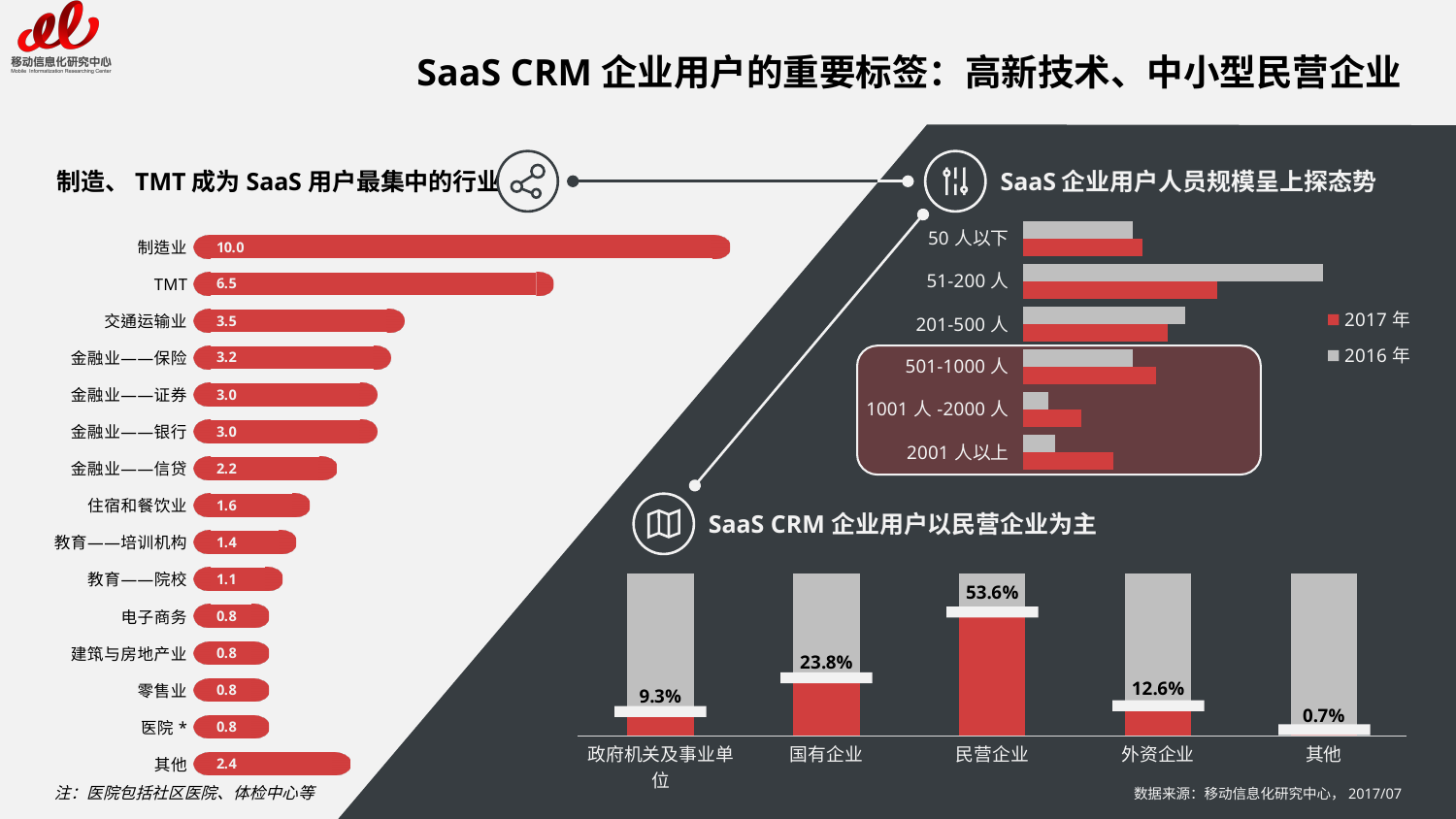
In the chart titled "制造、TMT 成为 SaaS 用户最集中的行业", which is larger, the value for 交通运输业 or the value for 住宿和餐饮业? 交通运输业 In the chart titled "制造、TMT 成为 SaaS 用户最集中的行业", what is the value for 制造业? 10.0 In the chart titled "制造、TMT 成为 SaaS 用户最集中的行业", what is the difference between the values for 制造业 and TMT? 3.5 In the chart titled "制造、TMT 成为 SaaS 用户最集中的行业", which industry has the highest value? 制造业 In the chart titled "SaaS CRM 企业用户以民营企业为主", what is the value for 民营企业? 53.6% In the chart titled "SaaS 企业用户人员规模呈上探态势", for 51-200 人, which year has the longer bar, 2017 年 or 2016 年? 2016 年 In the chart titled "SaaS 企业用户人员规模呈上探态势", how many series does the legend list? 2 In the chart titled "制造、TMT 成为 SaaS 用户最集中的行业", what is the value for 金融业——信贷? 2.2 In the chart titled "SaaS 企业用户人员规模呈上探态势", for 2001 人以上, which year has the longer bar, 2017 年 or 2016 年? 2017 年 In the chart titled "SaaS CRM 企业用户以民营企业为主", which category has the lowest value? 其他 In the chart titled "制造、TMT 成为 SaaS 用户最集中的行业", how many industry categories are shown? 15 In the chart titled "SaaS CRM 企业用户以民营企业为主", what is the difference between the values for 国有企业 and 外资企业? 11.2%